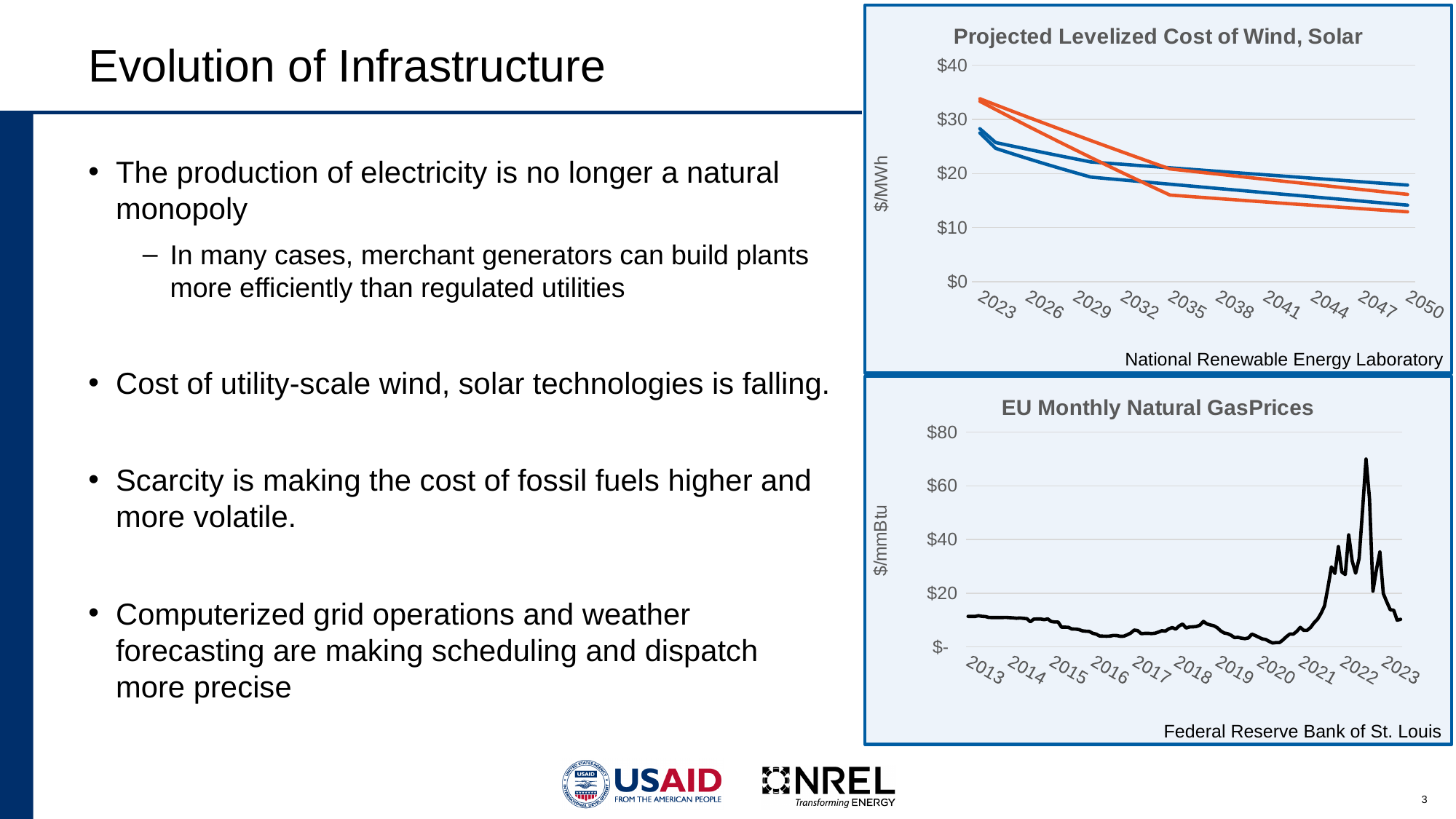
In the 'Projected Levelized Cost of Wind, Solar' chart, are the values of the orange lines in 2050 greater or less than $20? less In the 'EU Monthly Natural GasPrices' chart, is the value in 2013 greater or less than $20? less What kind of chart is the 'EU Monthly Natural GasPrices' chart? line chart In the 'Projected Levelized Cost of Wind, Solar' chart, how many lines are plotted? 4 What kind of chart is the 'Projected Levelized Cost of Wind, Solar' chart? line chart In the 'Projected Levelized Cost of Wind, Solar' chart, how many year labels are shown on the x axis? 10 What unit is shown on the y axis of the 'EU Monthly Natural GasPrices' chart? $/mmBtu In the 'Projected Levelized Cost of Wind, Solar' chart, are the values in 2023 greater or less than $20? greater In the 'EU Monthly Natural GasPrices' chart, around which year labelled on the x axis does the price peak? 2022 In the 'Projected Levelized Cost of Wind, Solar' chart, do the lines rise or fall from 2023 to 2050? fall What source is credited below the 'Projected Levelized Cost of Wind, Solar' chart? National Renewable Energy Laboratory